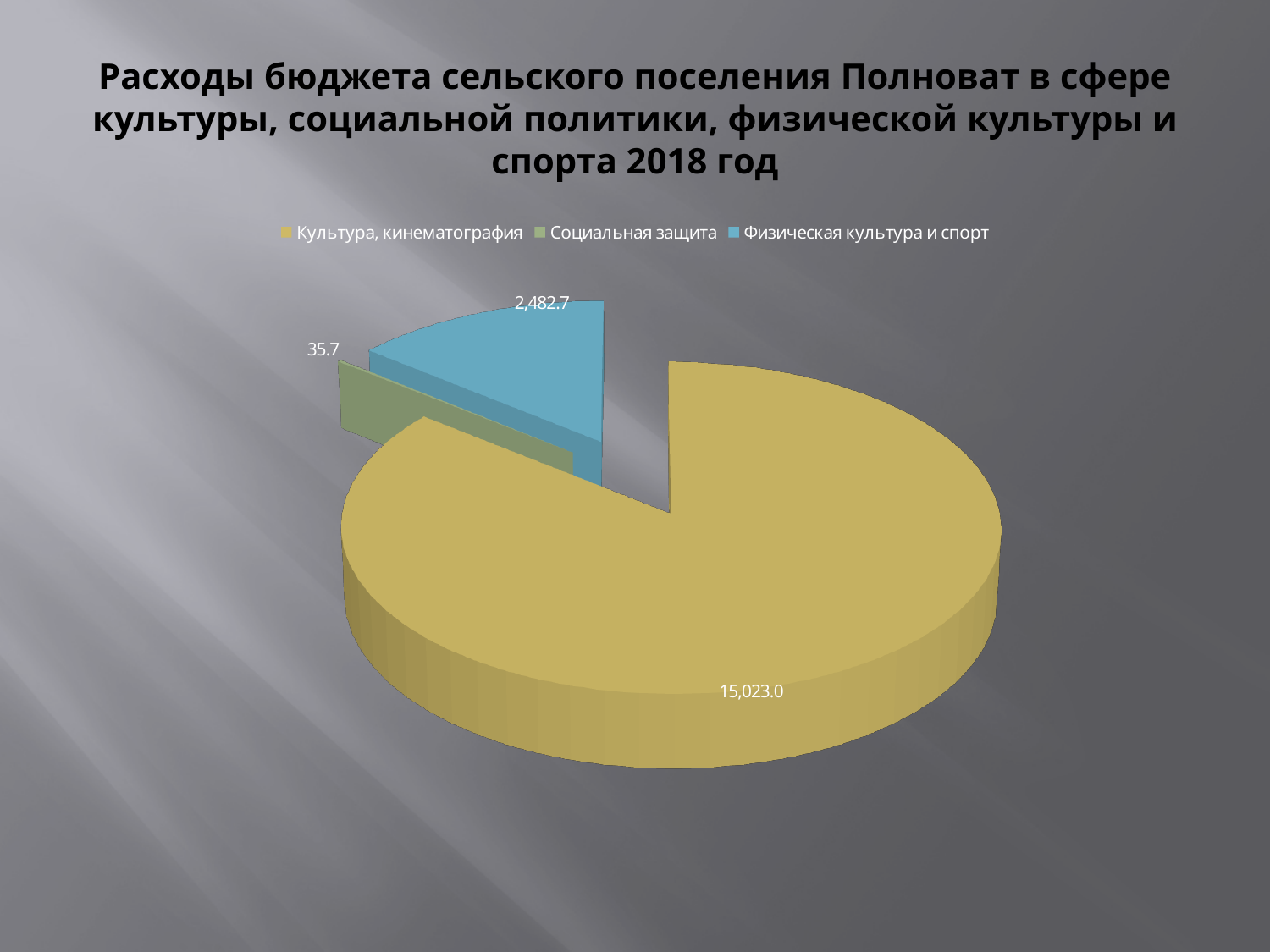
What is the value for Физическая культура и спорт? 2,482.7 What is the total of all three slices in the pie chart? 17,541.4 What is the difference between the values for Физическая культура и спорт and Социальная защита? 2,447.0 How many categories does the pie chart show? 3 What is the difference between the values for Культура, кинематография and Физическая культура и спорт? 12,540.3 Which category has the smallest slice of the pie? Социальная защита Which category has the largest slice of the pie? Культура, кинематография Which is larger, the value for Физическая культура и спорт or the value for Социальная защита? Физическая культура и спорт What is the value for Культура, кинематография? 15,023.0 What colour is the slice for Физическая культура и спорт? Blue What kind of chart is shown on the slide? Pie chart What is the value for Социальная защита? 35.7